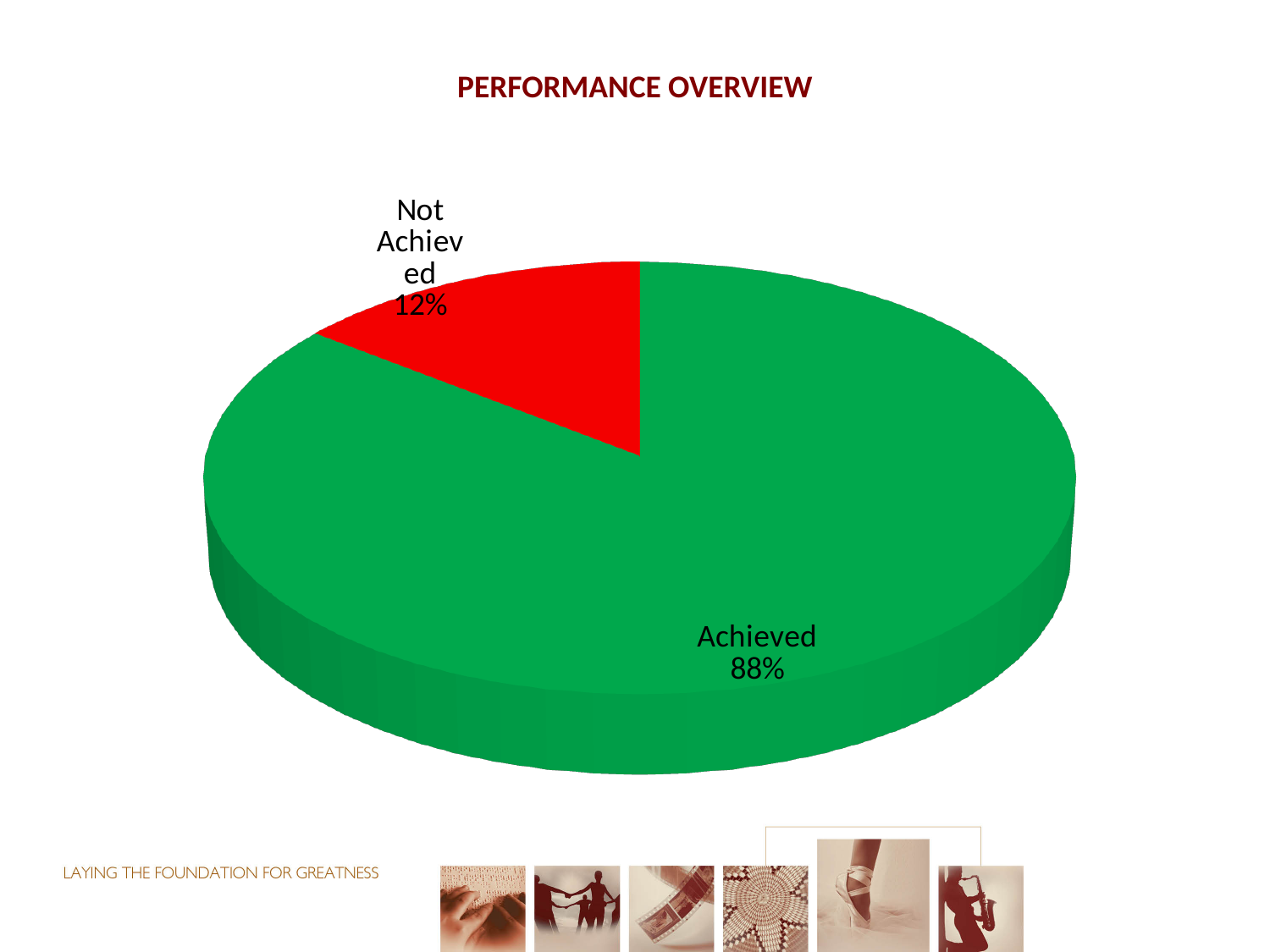
Which slice is the smallest? Not Achieved What share of the pie does the Not Achieved slice represent? 12% How many slices does the pie chart have? 2 Which slice is the largest? Achieved What is the difference between the Achieved and Not Achieved values? 76% Which is larger, Achieved or Not Achieved? Achieved What is the title of the chart? PERFORMANCE OVERVIEW What kind of chart is shown on the slide? Pie chart What is the value for Achieved? 88% What is the value for Not Achieved? 12% What colour is the Achieved slice? Green